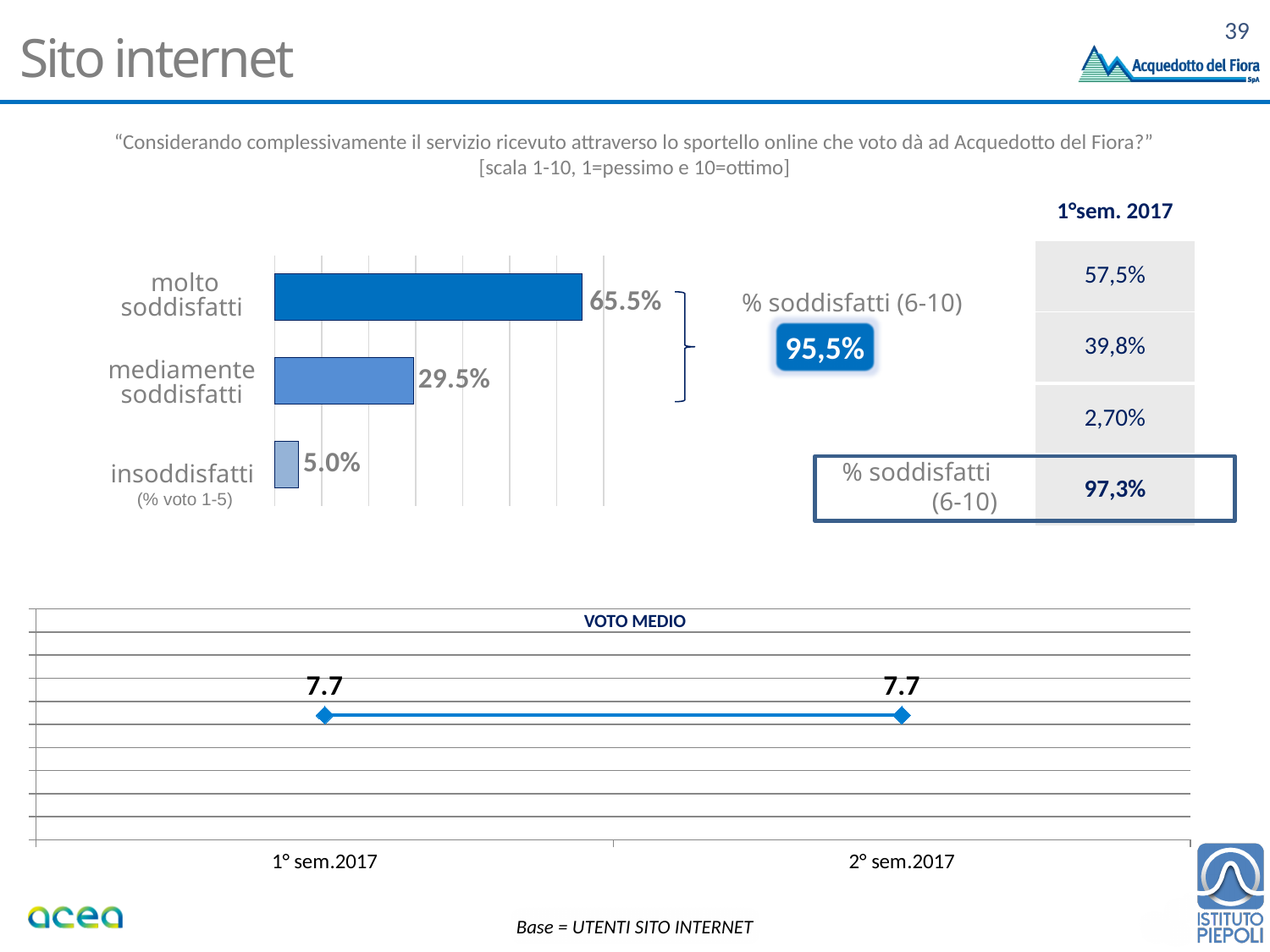
In the horizontal bar chart, what is the difference between 'mediamente soddisfatti' and 'insoddisfatti'? 24.5% How many categories does the horizontal bar chart show? 3 What kind of chart is the 'VOTO MEDIO' chart? line chart In the horizontal bar chart, which category has the highest value? molto soddisfatti In the horizontal bar chart, what is the value for 'mediamente soddisfatti'? 29.5% In the horizontal bar chart, what is the value for 'molto soddisfatti'? 65.5% In the horizontal bar chart, which is larger: 'molto soddisfatti' or 'mediamente soddisfatti'? molto soddisfatti What kind of chart is the chart at the top left of the slide? bar chart In the 'VOTO MEDIO' chart, do the values rise, fall or stay the same from '1° sem.2017' to '2° sem.2017'? stay the same In the 'VOTO MEDIO' chart, what is the value for '2° sem.2017'? 7.7 In the horizontal bar chart, what is the value for 'insoddisfatti'? 5.0% In the horizontal bar chart, which category has the lowest value? insoddisfatti